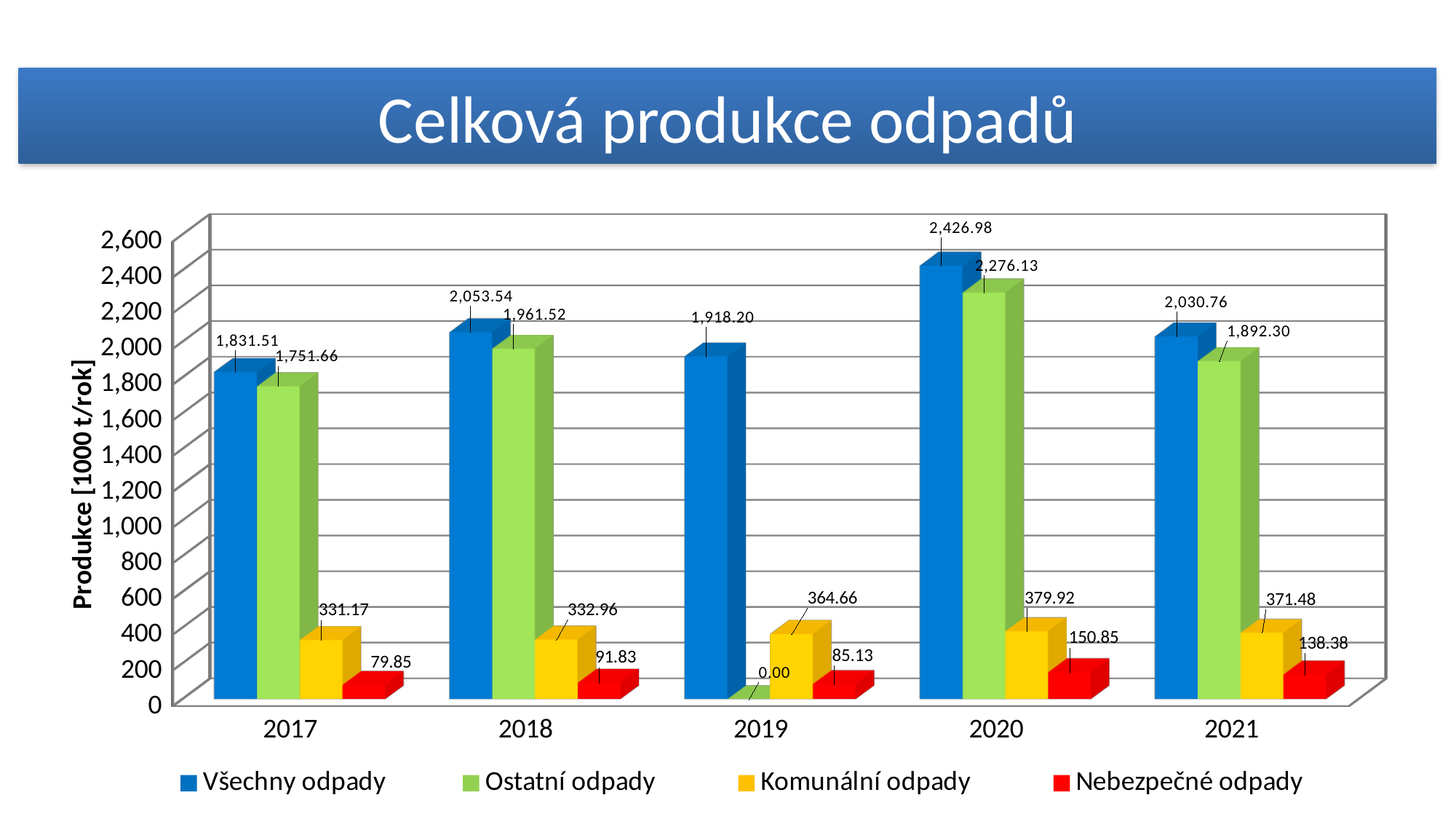
What is the value for Komunální odpady in 2019? 364.66 How many series does the legend list? 4 What is the value for Ostatní odpady in 2019? 0.00 What kind of chart is shown on the slide? bar chart Is the value for Všechny odpady in 2018 greater or less than 2,000? greater What is the value for Nebezpečné odpady in 2017? 79.85 In which year is Nebezpečné odpady lowest? 2017 Which is larger: Komunální odpady in 2020 or Komunální odpady in 2021? Komunální odpady in 2020 In which year is Všechny odpady highest? 2020 What is the difference between Všechny odpady and Ostatní odpady in 2020? 150.85 How many years are shown on the x axis? 5 What is the value for Všechny odpady in 2020? 2,426.98